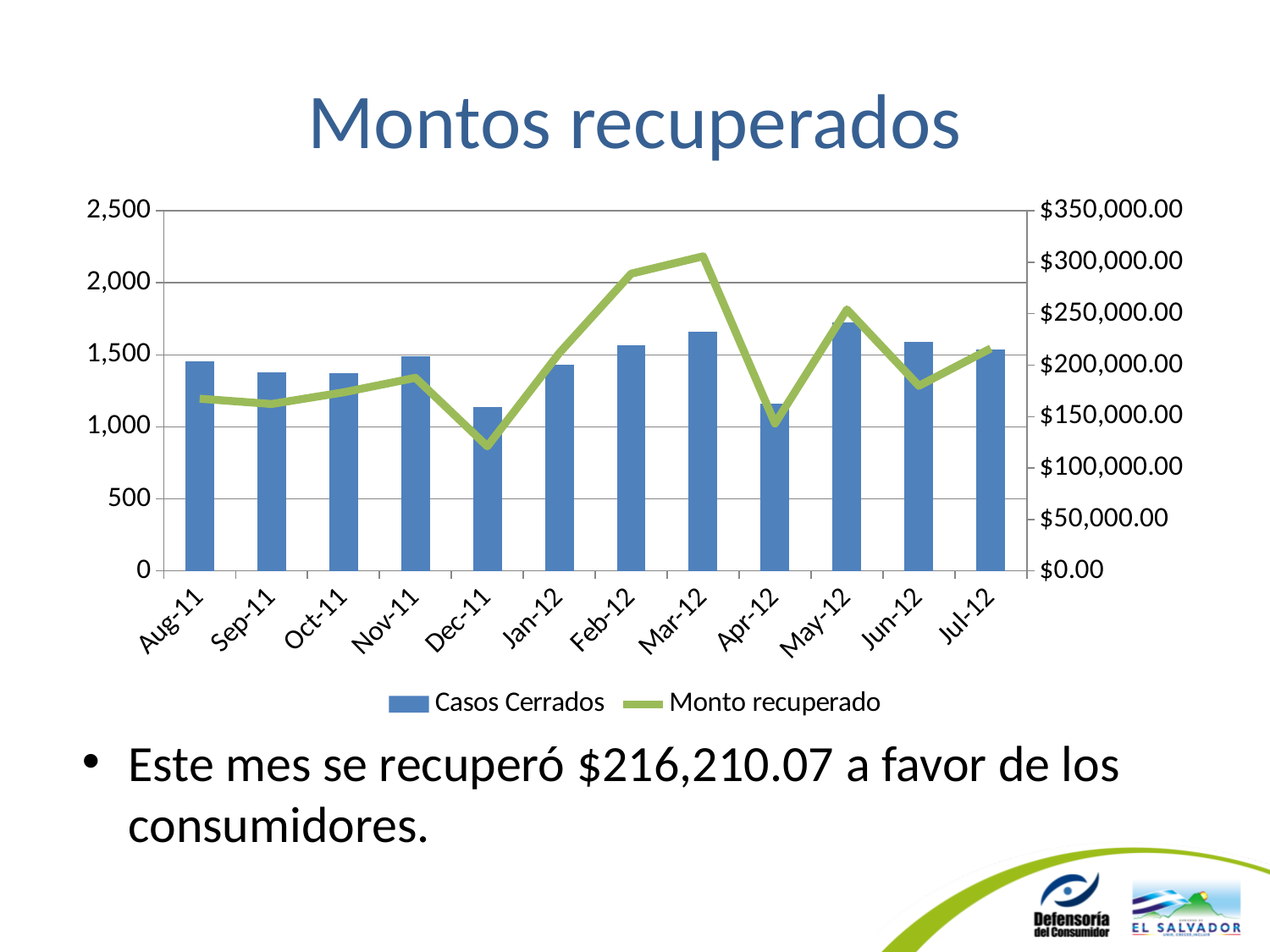
In which month does the Monto recuperado line reach its lowest value? Dec-11 What is the title of the chart? Montos recuperados Is the Casos Cerrados value for Dec-11 greater or less than 1,500? less Is the Casos Cerrados value for Mar-12 greater or less than 1,500? greater Which month has the larger Monto recuperado value, Feb-12 or Apr-12? Feb-12 How many months are shown on the x axis of the chart? 12 What kind of chart is shown on the slide? Combined bar and line chart How many series does the chart legend list? 2 Does the Monto recuperado line rise or fall from Dec-11 to Mar-12? rise Is the Monto recuperado value for Feb-12 greater or less than $250,000.00? greater Which series is shown as a line in the chart? Monto recuperado In which month does the Monto recuperado line reach its highest value? Mar-12